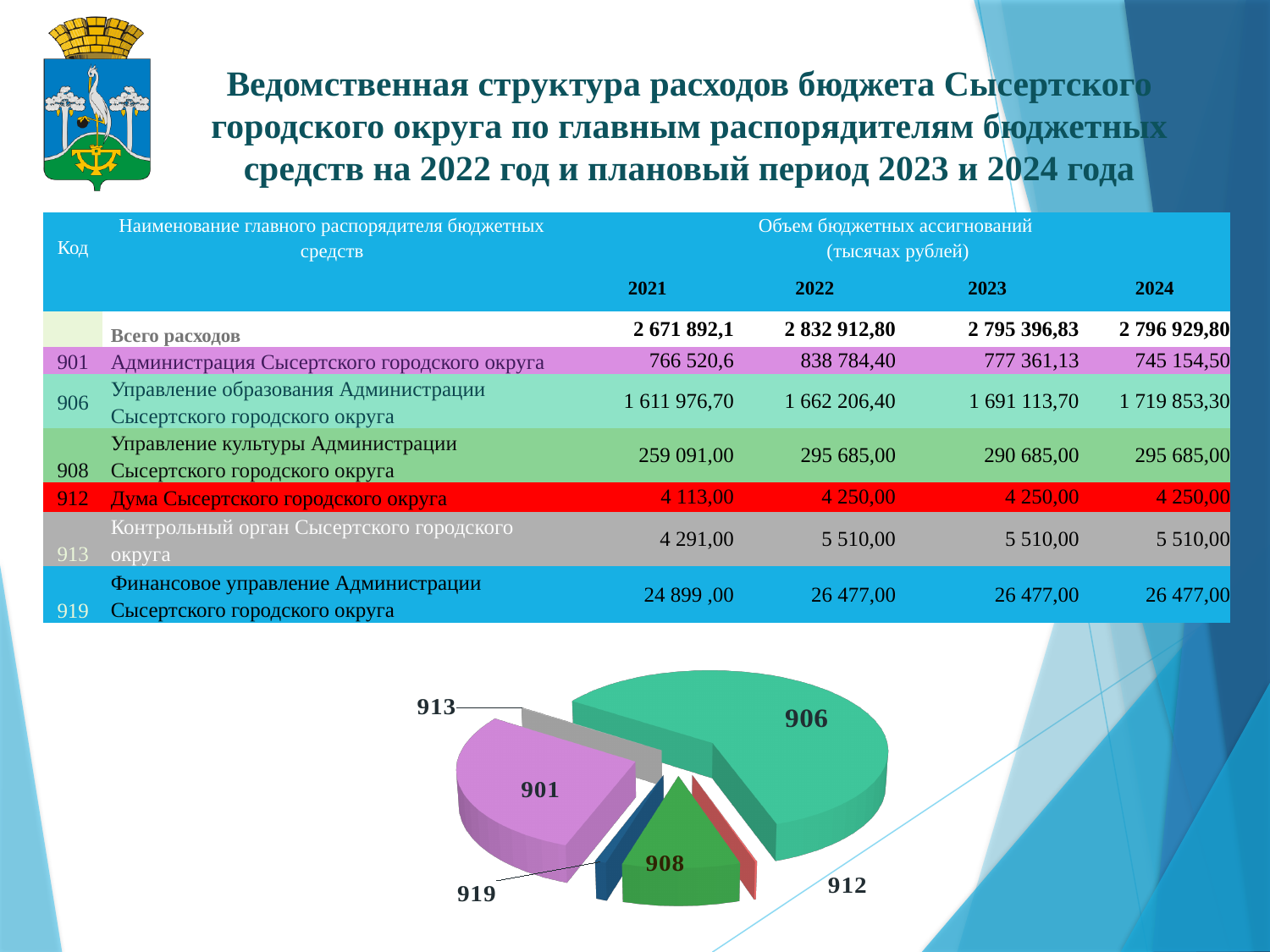
What colour is the slice labelled 913 in the pie chart? grey How many slices does the pie chart have? 6 In the pie chart, which slice is larger, 908 or 912? 908 In the pie chart, which slice is larger, 901 or 908? 901 Which code has the largest slice in the pie chart? 906 In the pie chart, which slice is larger, 906 or 901? 906 What kind of chart is shown at the bottom of the slide? pie chart What colour is the slice labelled 912 in the pie chart? red Which code has the second-largest slice in the pie chart? 901 Does the slice labelled 906 take up more or less than half of the pie chart? more